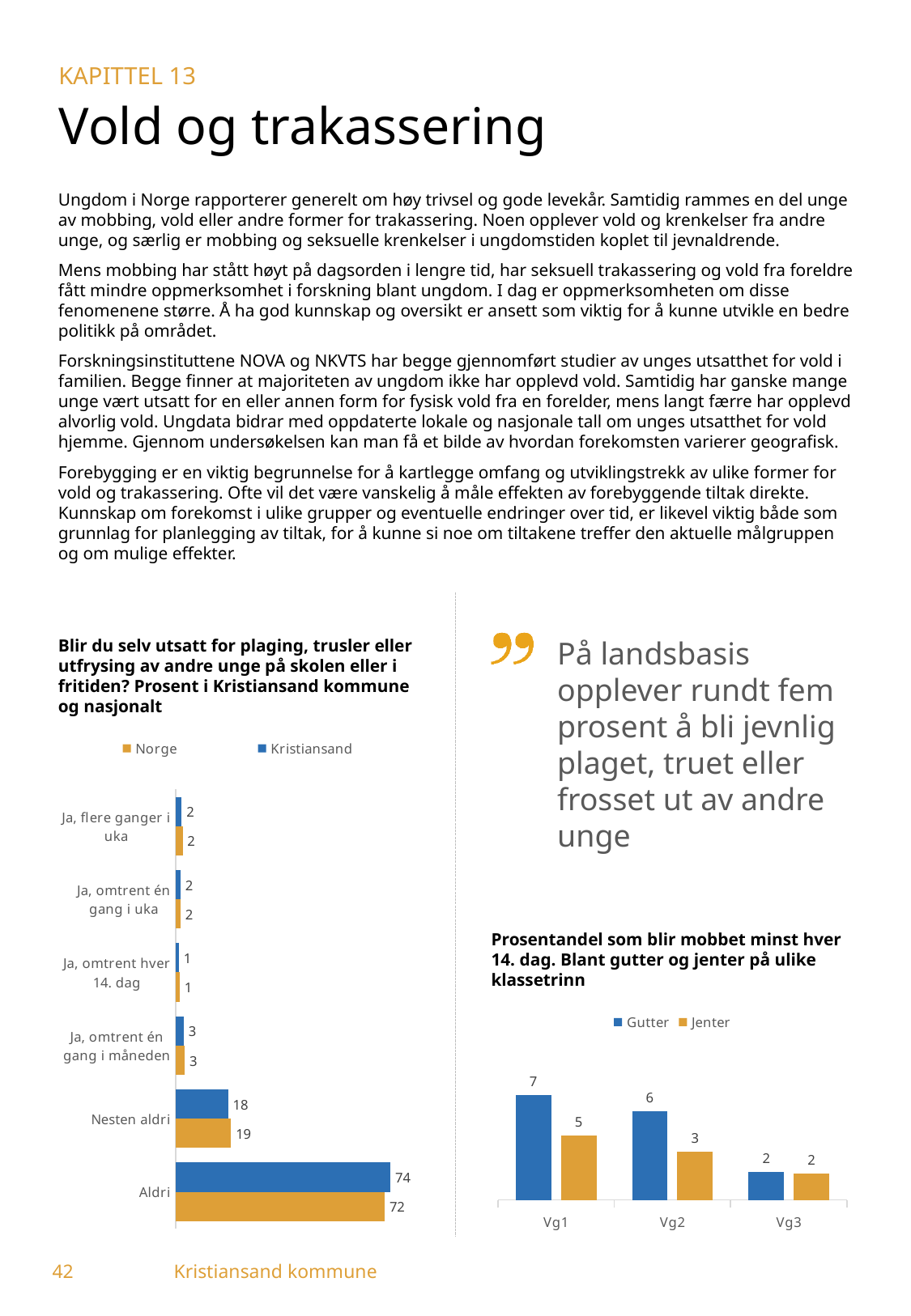
In the left chart (Blir du selv utsatt for plaging...), how many categories are shown? 6 In the left chart (Blir du selv utsatt for plaging...), what is the difference between the Kristiansand and Norge values for 'Aldri'? 2 In the left chart (Blir du selv utsatt for plaging...), what is the value for Norge in the category 'Nesten aldri'? 19 In the right chart (Prosentandel som blir mobbet minst hver 14. dag), what is the value for Gutter at Vg2? 6 In the left chart (Blir du selv utsatt for plaging...), which category has the lowest values for both series? Ja, omtrent hver 14. dag In the right chart (Prosentandel som blir mobbet minst hver 14. dag), what is the difference between Gutter and Jenter at Vg2? 3 In the right chart (Prosentandel som blir mobbet minst hver 14. dag), which class level has the highest value for Gutter? Vg1 In the right chart (Prosentandel som blir mobbet minst hver 14. dag), do the Gutter values rise or fall from Vg1 to Vg3? fall In the left chart (Blir du selv utsatt for plaging...), what is the value for Kristiansand in the category 'Aldri'? 74 What kind of chart is the right chart (Prosentandel som blir mobbet minst hver 14. dag)? bar chart In the left chart (Blir du selv utsatt for plaging...), which is larger for 'Nesten aldri': Norge or Kristiansand? Norge In the left chart (Blir du selv utsatt for plaging...), how many series does the legend list? 2